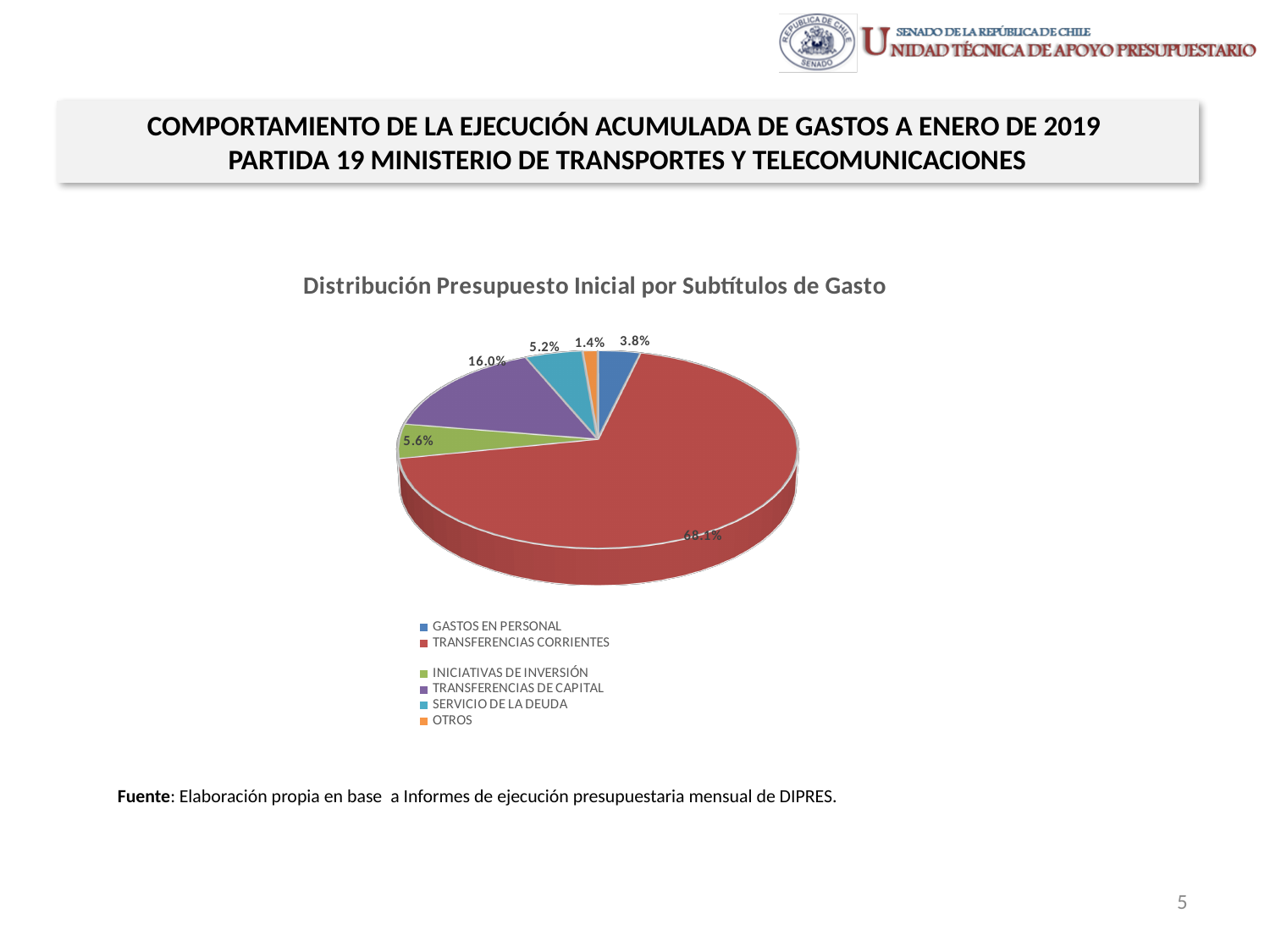
What share of the pie does TRANSFERENCIAS DE CAPITAL represent? 16.0% Which is larger, the share for INICIATIVAS DE INVERSIÓN or the share for GASTOS EN PERSONAL? INICIATIVAS DE INVERSIÓN What is the value shown for GASTOS EN PERSONAL? 3.8% What is the title of the chart? Distribución Presupuesto Inicial por Subtítulos de Gasto What type of chart is shown on the slide? Pie chart What is the difference between the shares of TRANSFERENCIAS DE CAPITAL and INICIATIVAS DE INVERSIÓN? 10.4% Which category has the largest share of the pie? TRANSFERENCIAS CORRIENTES Which category has the smallest share of the pie? OTROS How many categories does the legend list? 6 What share of the pie does TRANSFERENCIAS CORRIENTES represent? 68.1% What is the value shown for OTROS? 1.4% What is the value shown for SERVICIO DE LA DEUDA? 5.2%